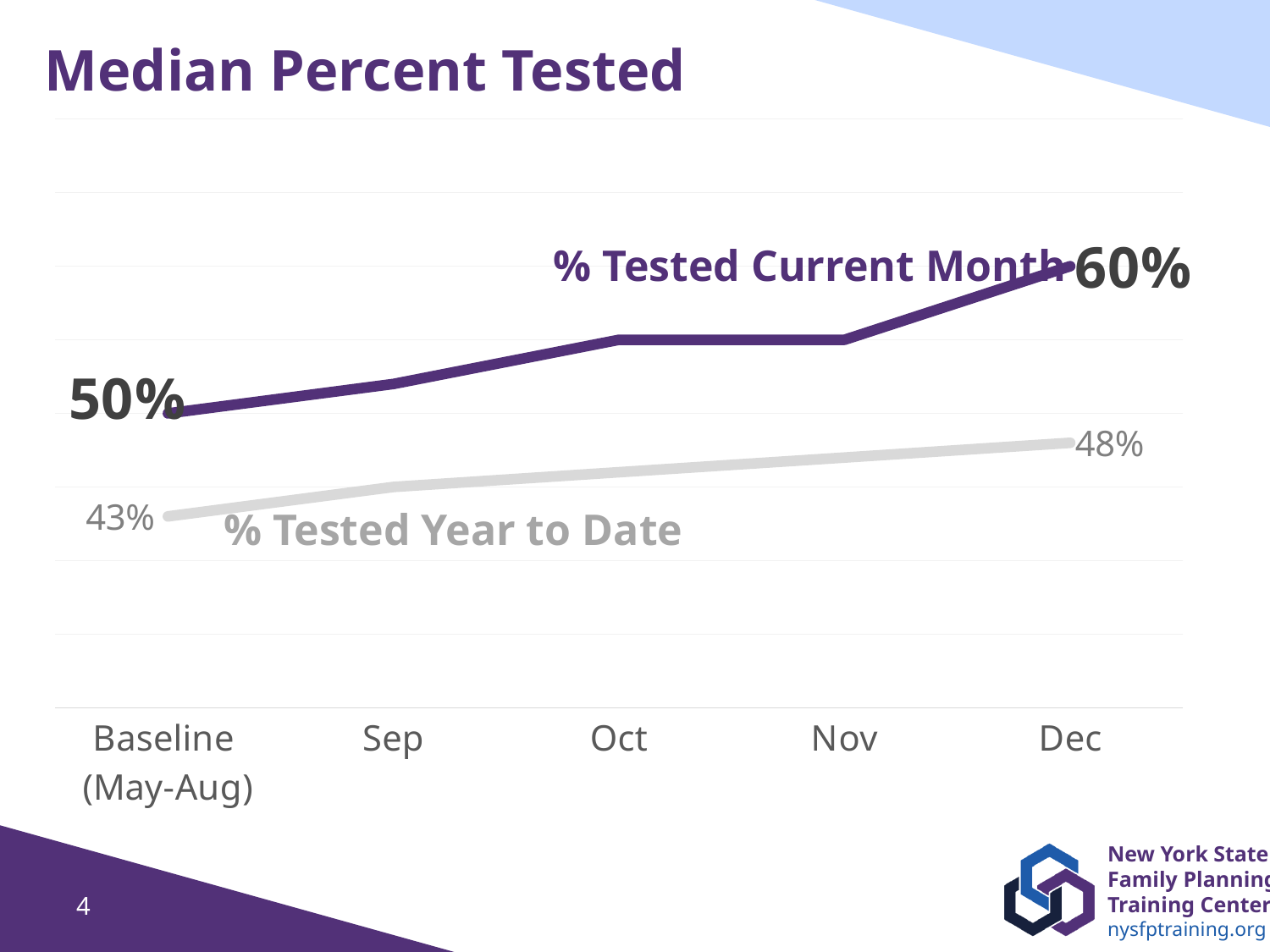
By how many percentage points did % Tested Current Month increase from Baseline (May-Aug) to Dec? 10 percentage points What is the value of % Tested Current Month in Dec? 60% What is the value of % Tested Year to Date at Baseline (May-Aug)? 43% How many series are plotted on the chart? 2 What kind of chart is shown on the slide? Line chart What is the title of the chart? Median Percent Tested How many time periods are shown on the x axis? 5 What is the value of % Tested Current Month at Baseline (May-Aug)? 50% Does % Tested Current Month rise or fall from Baseline (May-Aug) to Dec? Rises By how many percentage points did % Tested Year to Date increase from Baseline (May-Aug) to Dec? 5 percentage points What is the value of % Tested Year to Date in Dec? 48% In Dec, which series has the higher value: % Tested Current Month or % Tested Year to Date? % Tested Current Month